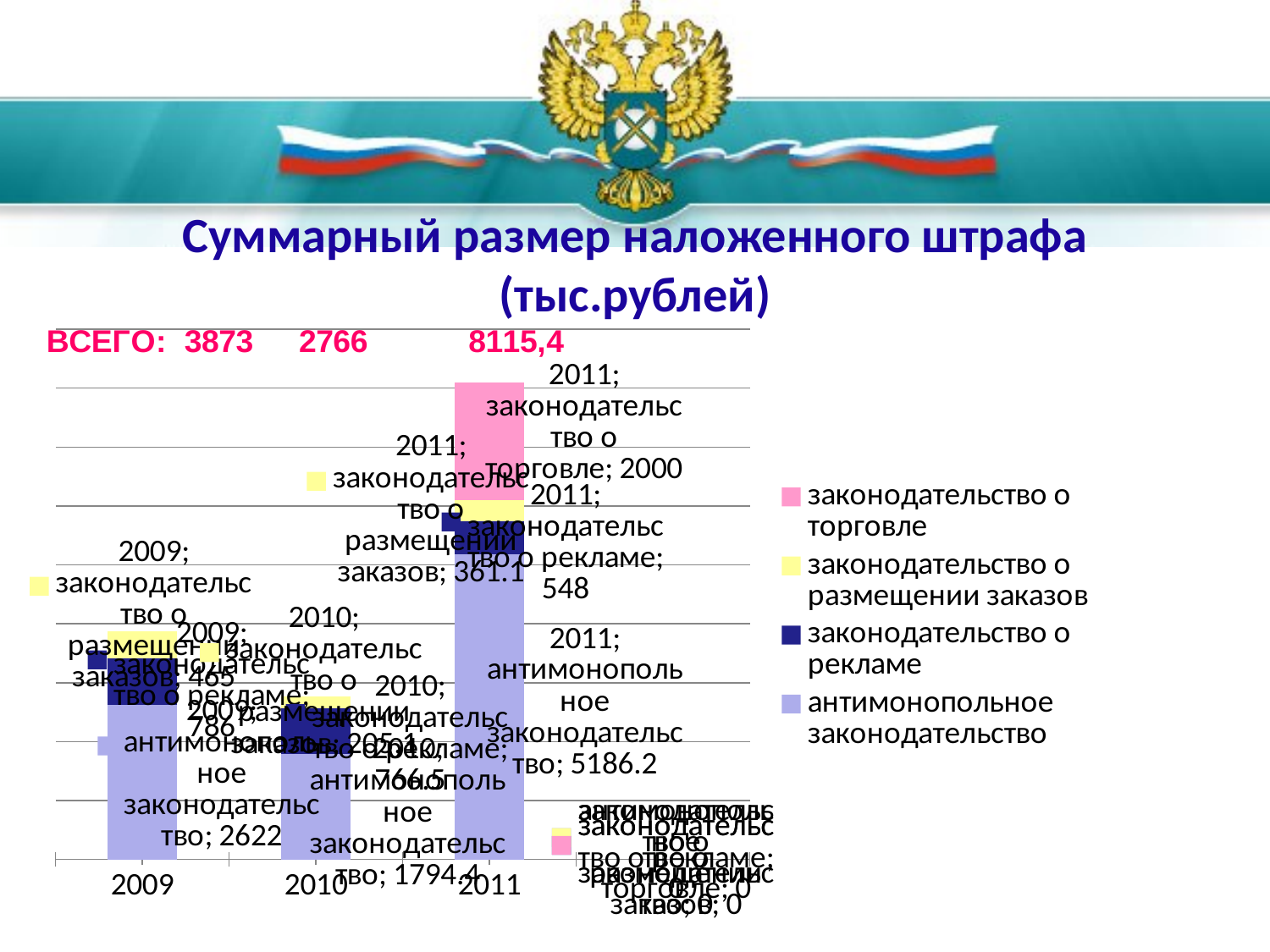
What is the value for антимонопольное законодательство in 2011? 5186.2 What is the value for законодательство о рекламе in 2009? 786 What kind of chart is shown on the slide? stacked bar chart Which year has the lowest total fine? 2010 What is the value for антимонопольное законодательство in 2010? 1794.4 Which is larger: законодательство о рекламе in 2009 or in 2011? 2009 What is the total of the stacked bar for 2009? 3873 What is the value for законодательство о торговле in 2011? 2000 What is the value for законодательство о размещении заказов in 2010? 205.1 What is the difference between антимонопольное законодательство in 2011 and in 2009? 2564.2 Which year has the highest total fine? 2011 How many series does the legend list? 4